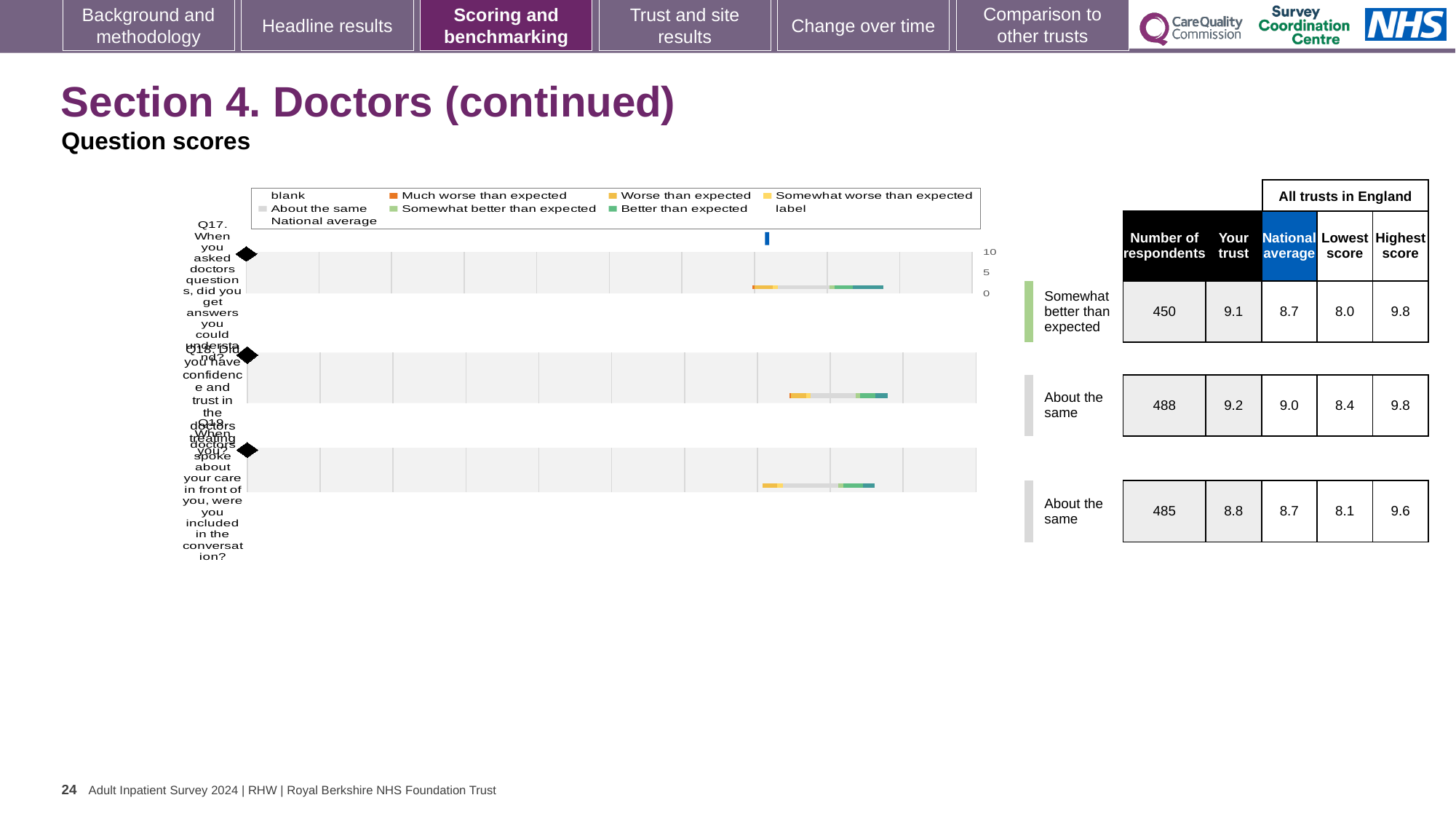
What is the highest score across all trusts in England for Q19? 9.6 How many respondents answered Q19 (When doctors spoke about your care in front of you, were you included in the conversation)? 485 For Q18, which is larger: the 'Your trust' score or the national average? Your trust Is the 'Your trust' score for Q19 greater or less than 5 on the chart axis? greater What is the 'Your trust' score for Q17 (When you asked doctors questions, did you get answers you could understand)? 9.1 What is the national average score for Q18 (Did you have confidence and trust in the doctors treating you)? 9.0 What kind of chart is shown on the slide? bar chart How many questions (categories) are plotted in the chart? 3 What is the difference between the 'Your trust' score and the national average for Q17? 0.4 Which question has the lowest 'Your trust' score? Q19 Which question has the highest 'Your trust' score? Q18 What benchmark category is Q17 assigned to? Somewhat better than expected